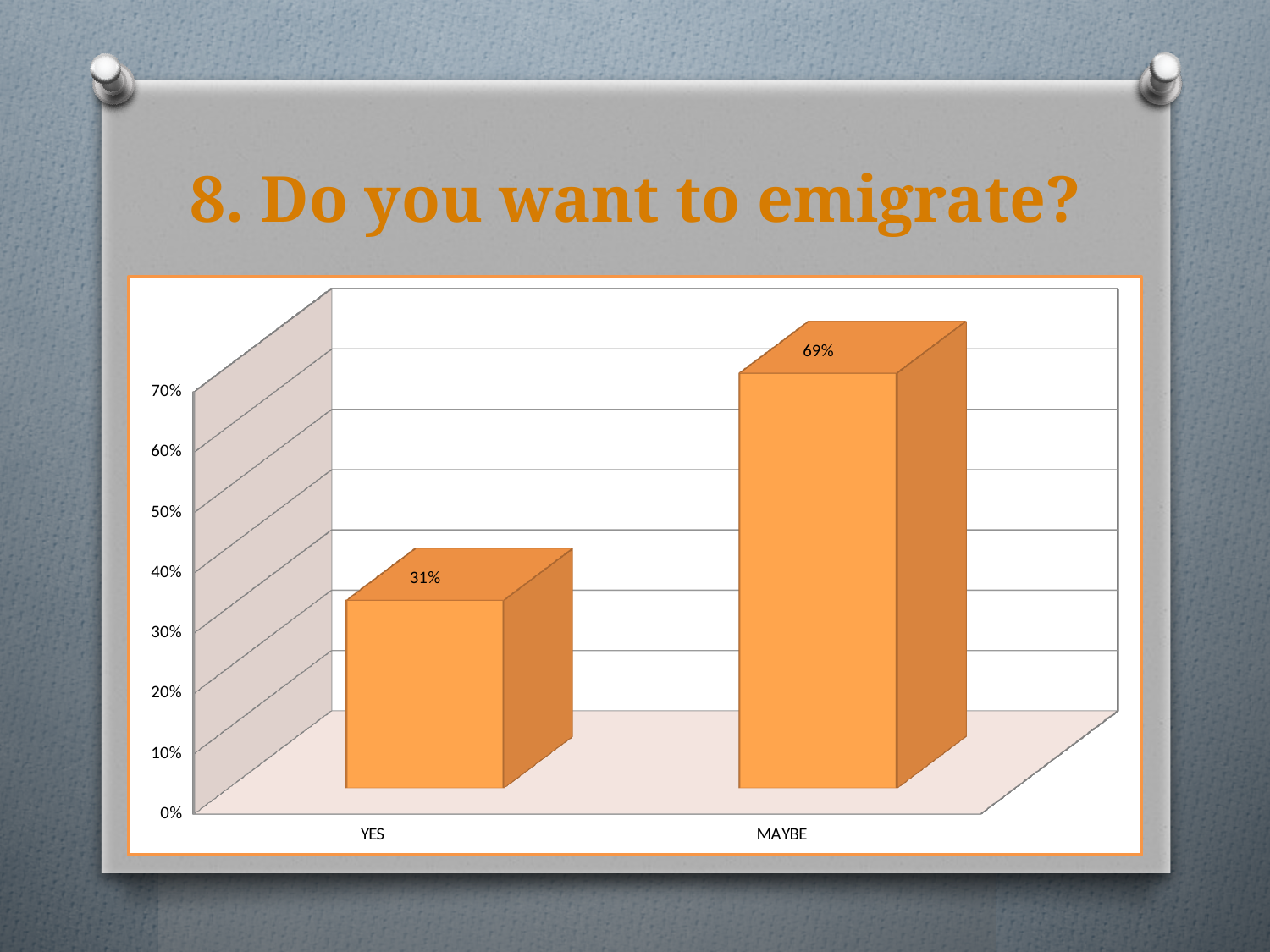
What kind of chart is shown on the slide? bar chart Is the value for YES greater or less than 40%? less What colour are the bars in the chart? orange Which is larger, the value for YES or the value for MAYBE? MAYBE What is the value for MAYBE? 69% What is the title of the slide above the chart? 8. Do you want to emigrate? Which category has the lowest value? YES Which category has the highest value? MAYBE Is the value for MAYBE greater or less than 60%? greater What is the value for YES? 31% What is the difference between the values for MAYBE and YES? 38% How many categories are shown on the x axis? 2